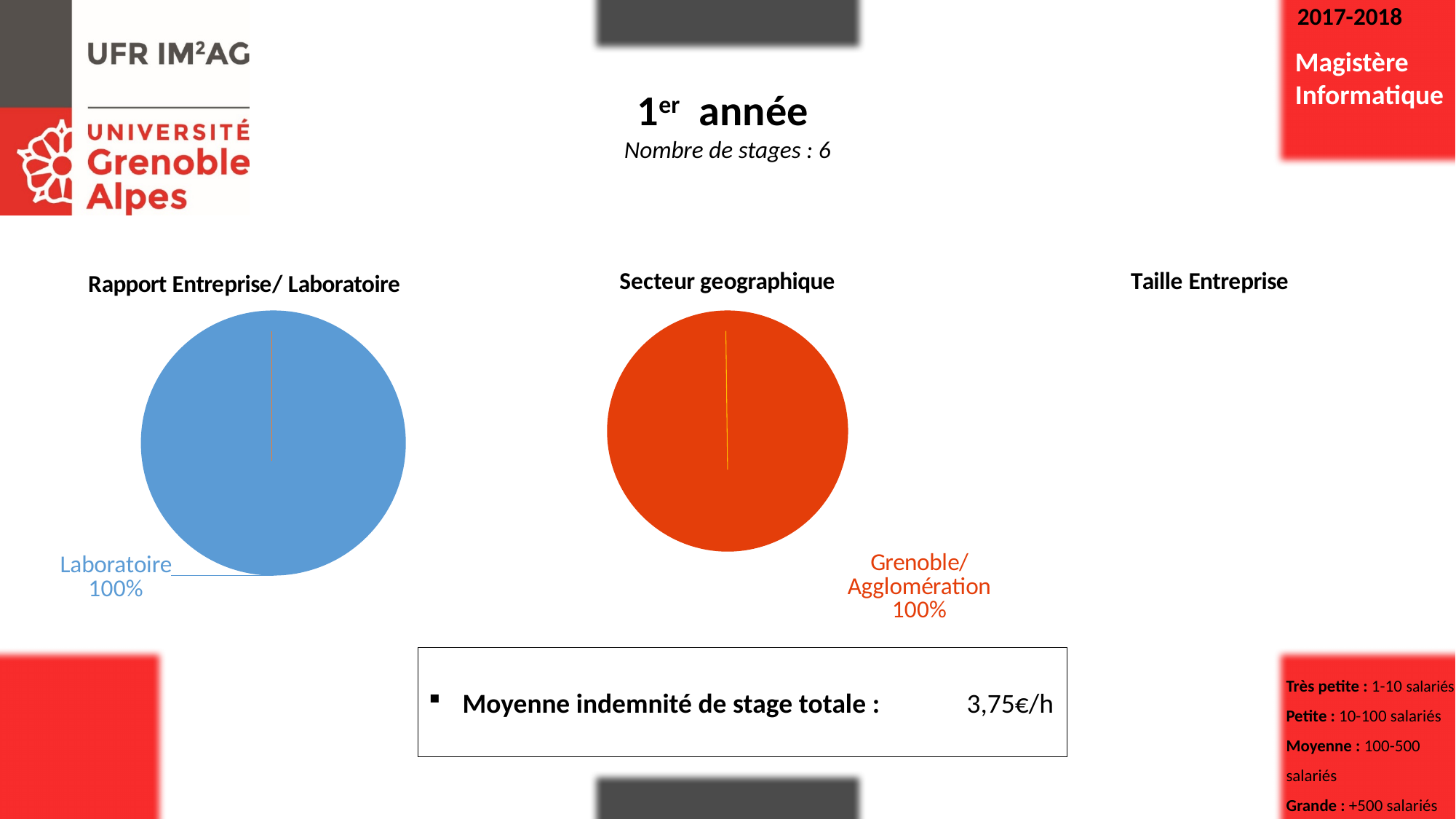
What kind of chart is the 'Secteur geographique' chart? Pie chart In the 'Secteur geographique' chart, which category makes up the whole pie? Grenoble/Agglomération In the 'Rapport Entreprise/ Laboratoire' chart, what share does Laboratoire have? 100% How many slices are labelled in the 'Secteur geographique' pie chart? 1 In the 'Secteur geographique' chart, what share does Grenoble/Agglomération have? 100% What colour is the pie in the 'Secteur geographique' chart? Orange-red How many slices are labelled in the 'Rapport Entreprise/ Laboratoire' pie chart? 1 What colour is the pie in the 'Rapport Entreprise/ Laboratoire' chart? Blue In the 'Rapport Entreprise/ Laboratoire' chart, which category makes up the whole pie? Laboratoire What kind of chart is the 'Rapport Entreprise/ Laboratoire' chart? Pie chart In the 'Rapport Entreprise/ Laboratoire' chart, is the share for Laboratoire greater or less than 50%? greater